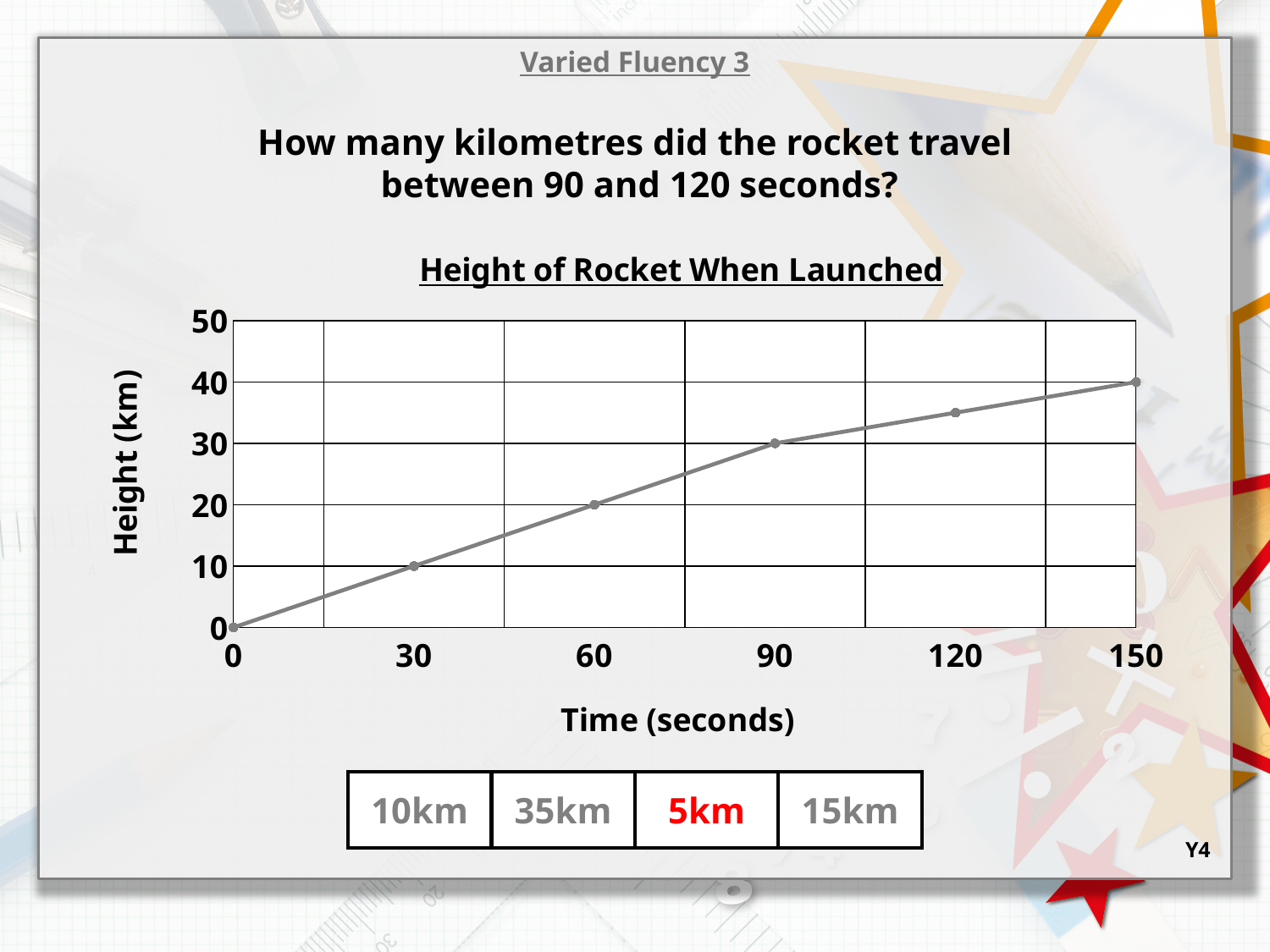
How many data points are plotted on the line? 6 What is the height of the rocket at 30 seconds? 10 km Is the height of the rocket at 120 seconds greater or less than 30 km? greater What is the height of the rocket at 90 seconds? 30 km What is the height of the rocket at 60 seconds? 20 km How much higher is the rocket at 150 seconds than at 90 seconds? 10 km What is the title of the chart? Height of Rocket When Launched At which time is the rocket's height lowest? 0 seconds Does the rocket's height rise or fall as time increases? rise What kind of chart is shown on the slide? line chart At which time is the rocket's height highest? 150 seconds What is the height of the rocket at 150 seconds? 40 km